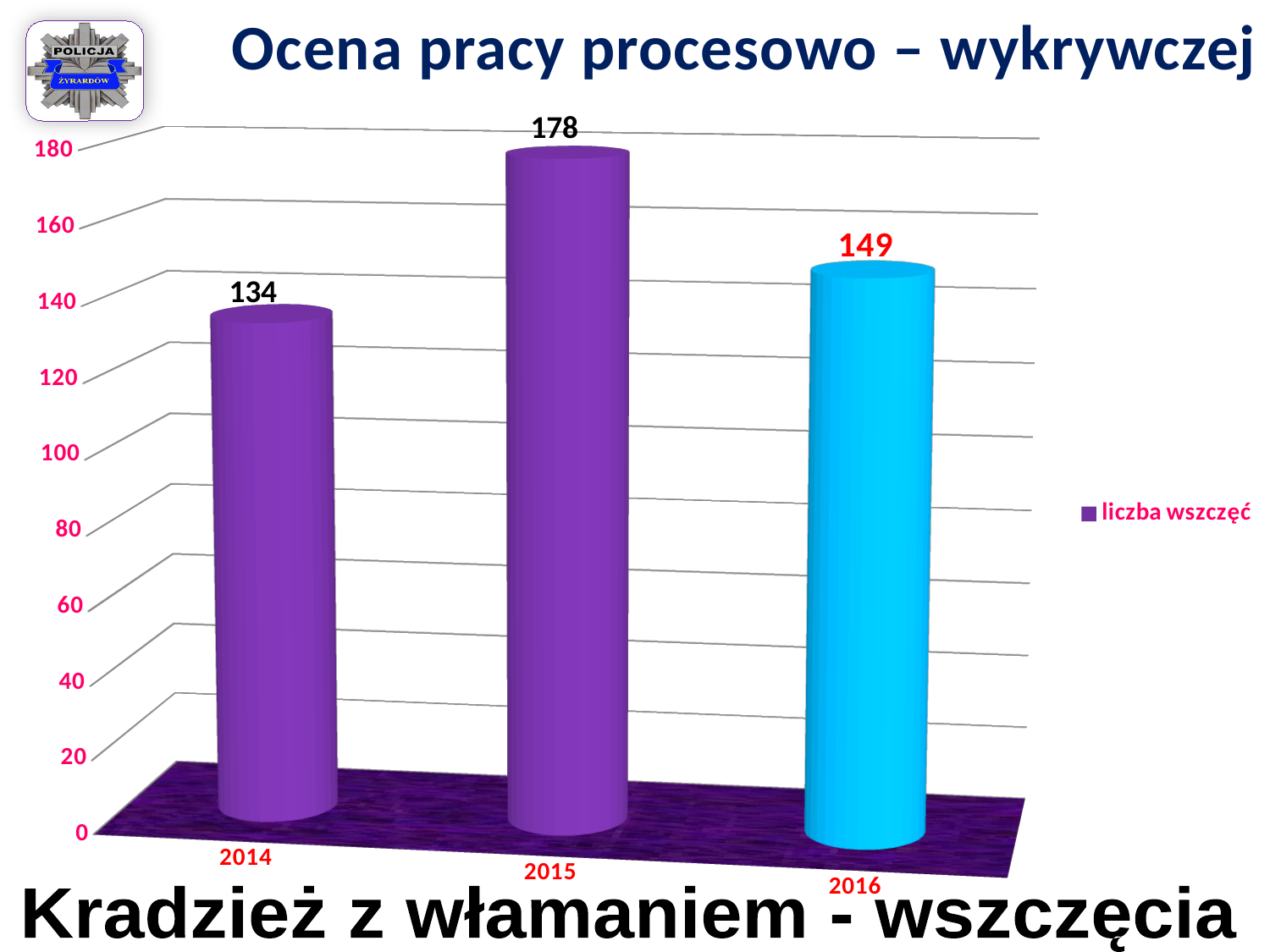
What is the difference between the values for 2016 and 2014? 15 What is the difference between the values for 2015 and 2016? 29 How many series does the legend list? 1 What is the value for 2014? 134 Which year has the highest value? 2015 What is the value for 2016? 149 Which year has the lowest value? 2014 How many years are shown on the x axis? 3 What kind of chart is shown? bar chart Which is larger, the value for 2014 or the value for 2016? 2016 What is the value for 2015? 178 What is the legend entry for the series? liczba wszczęć